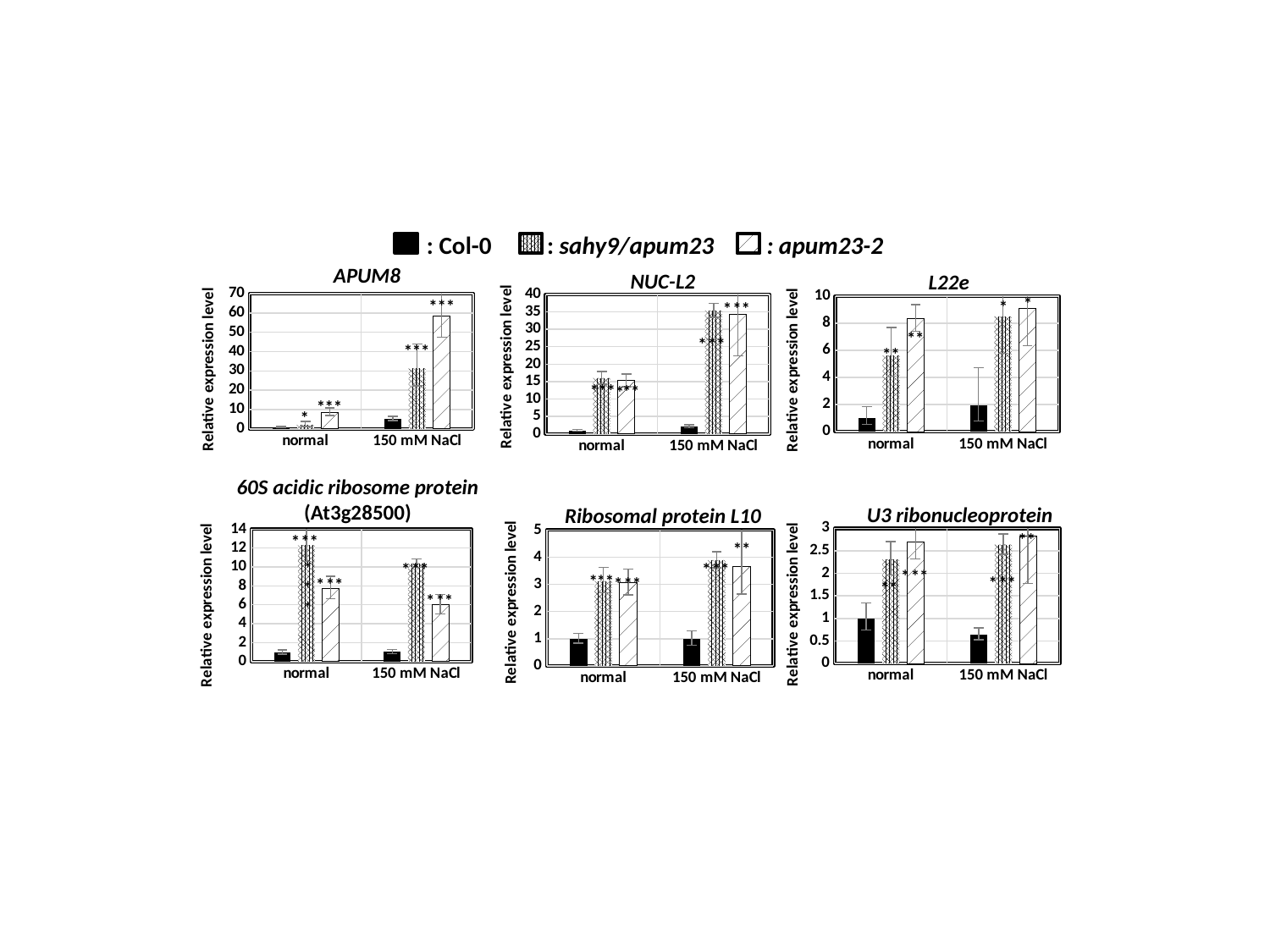
In the APUM8 chart, which series has the highest bar under 150 mM NaCl? apum23-2 In the APUM8 chart, is the value for apum23-2 under 150 mM NaCl greater or less than 50? greater In the 60S acidic ribosome protein (At3g28500) chart, is the value for sahy9/apum23 under normal conditions greater or less than 10? greater In the 60S acidic ribosome protein (At3g28500) chart, which series has the highest bar under normal conditions? sahy9/apum23 In the U3 ribonucleoprotein chart, is the value for sahy9/apum23 under normal conditions greater or less than 2? greater How many charts are shown on the slide? 6 In the L22e chart, which is larger under normal conditions: sahy9/apum23 or apum23-2? apum23-2 How many series does the shared legend at the top of the slide list? 3